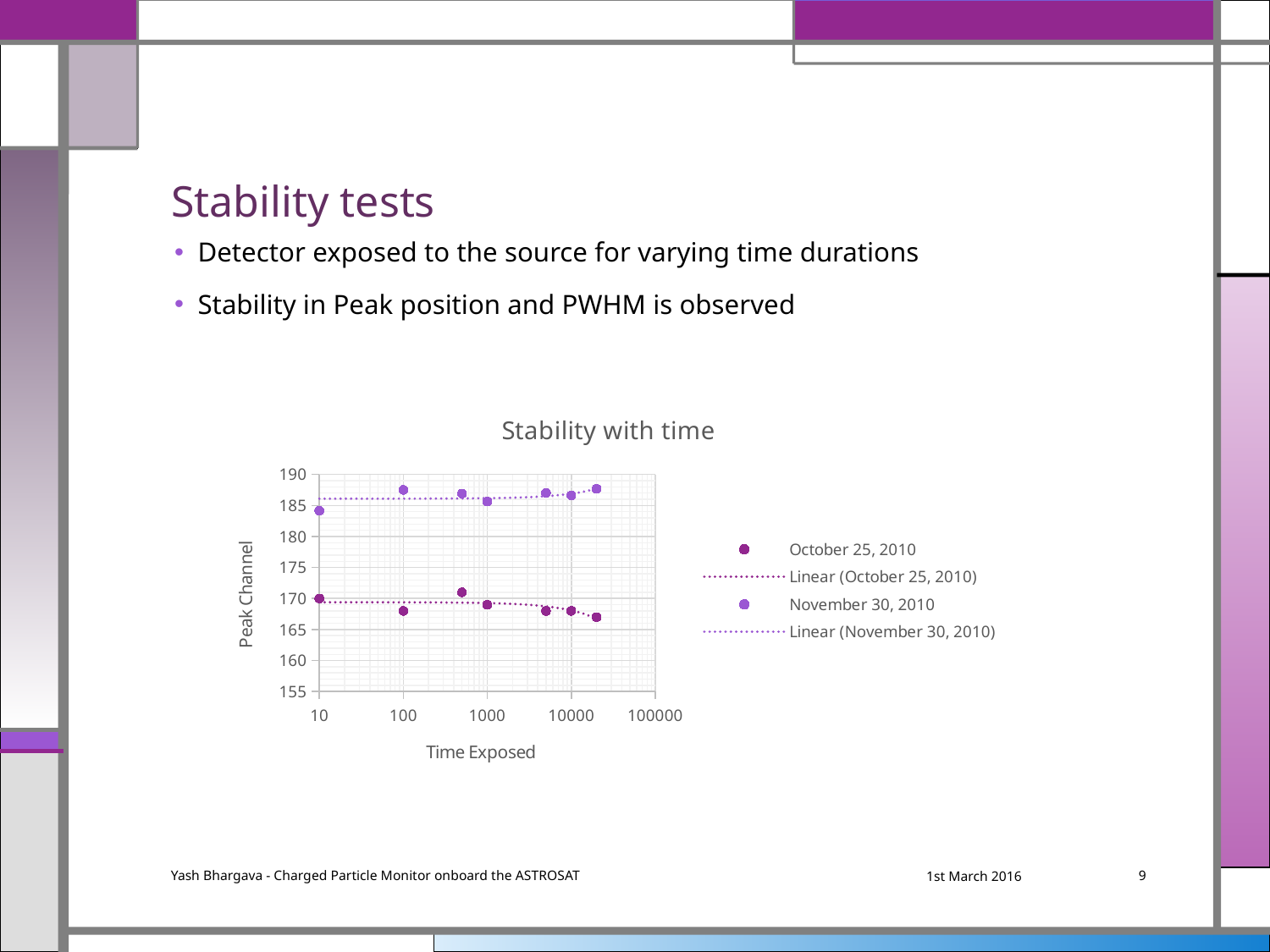
How many entries does the chart legend list? 4 Does the linear trendline for the October 25, 2010 series rise or fall as time exposed increases? fall Is the value for the October 25, 2010 series at a time exposed of 100 greater or less than 170? less At a time exposed of 100, which series has the higher peak channel, October 25, 2010 or November 30, 2010? November 30, 2010 What kind of chart is shown on the slide? scatter chart Is the value for the October 25, 2010 series at a time exposed of 20000 greater or less than 170? less Is the value for the November 30, 2010 series at a time exposed of 20000 greater or less than 185? greater How many data points are plotted for the October 25, 2010 series? 7 What is the title of the chart? Stability with time Does the linear trendline for the November 30, 2010 series rise or fall as time exposed increases? rise What is the label of the vertical axis of the chart? Peak Channel